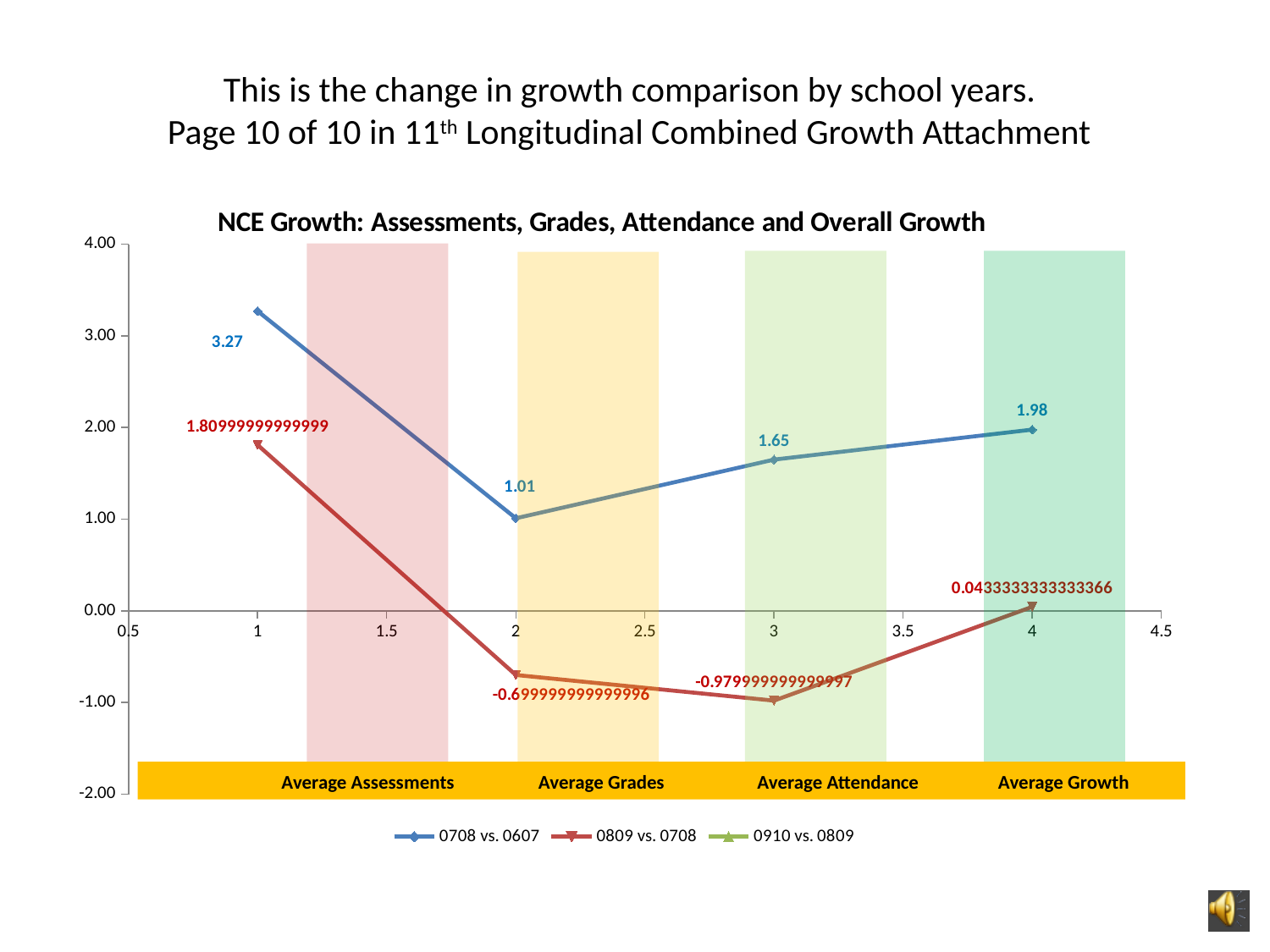
At Average Grades, which series has the larger value, 0708 vs. 0607 or 0809 vs. 0708? 0708 vs. 0607 What is the value for the 0809 vs. 0708 series at Average Attendance? -0.979999999999997 For the 0708 vs. 0607 series, which category has the highest value? Average Assessments What is the difference between the 0708 vs. 0607 values at Average Assessments and Average Grades? 2.26 What is the value for the 0708 vs. 0607 series at Average Growth? 1.98 For the 0708 vs. 0607 series, which category has the lowest value? Average Grades For the 0809 vs. 0708 series, which category has the lowest value? Average Attendance What kind of chart is shown on the slide? Line chart How many series does the legend list? 3 What is the value for the 0809 vs. 0708 series at Average Growth? 0.0433333333333366 What is the title of the chart? NCE Growth: Assessments, Grades, Attendance and Overall Growth What is the value for the 0708 vs. 0607 series at Average Assessments? 3.27